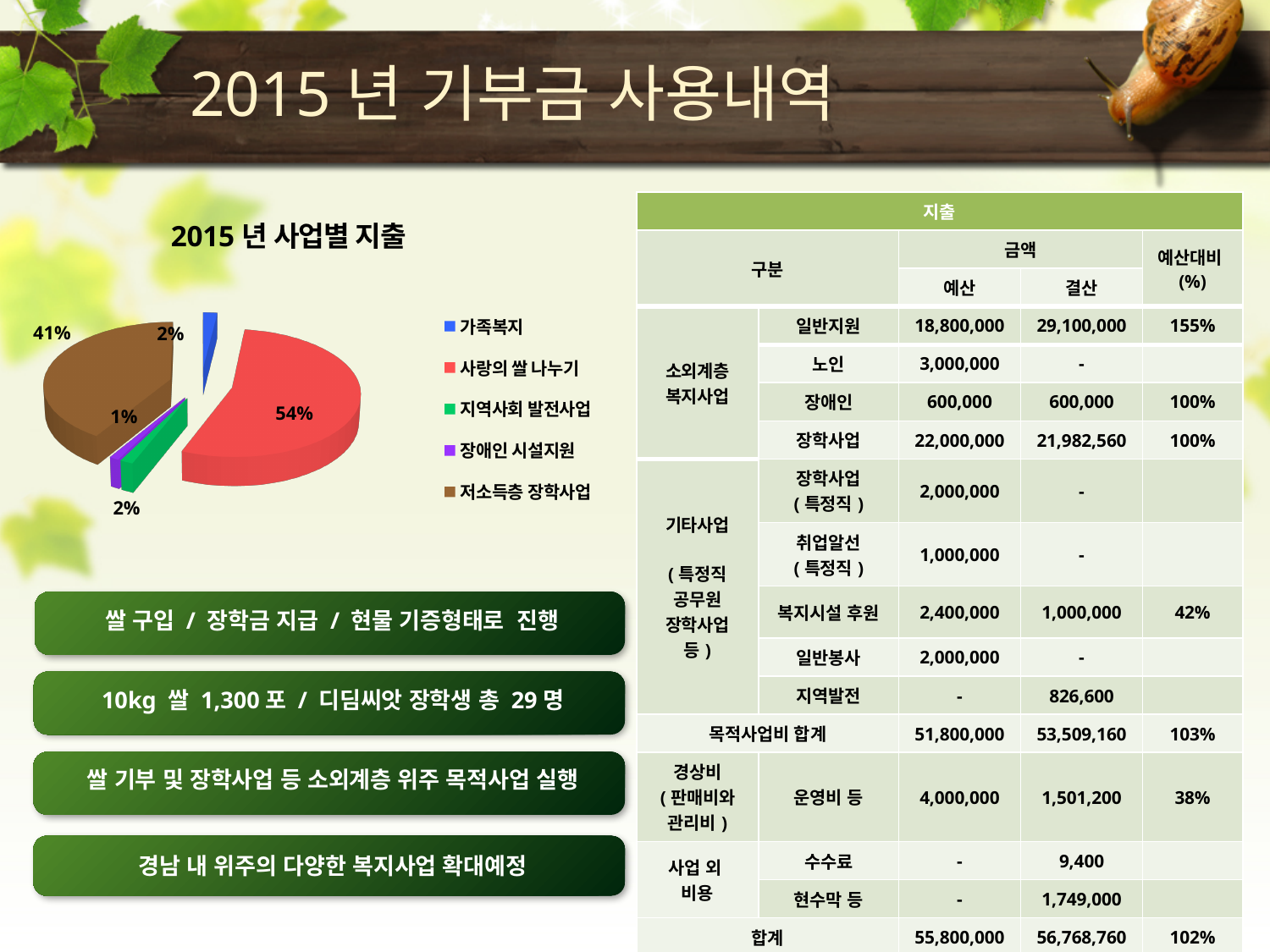
What share of the pie does 가족복지 have? 2% Which category has the smallest share of the pie? 장애인 시설지원 Which colour represents 저소득층 장학사업 in the pie chart? brown What is the difference in percentage points between 사랑의 쌀 나누기 and 저소득층 장학사업? 13% What is the title of the chart on the slide? 2015 년 사업별 지출 What share of the pie does 장애인 시설지원 have? 1% How many entries does the legend of the pie chart list? 5 Which category has the largest share of the pie? 사랑의 쌀 나누기 What share of the pie does 사랑의 쌀 나누기 have? 54% What kind of chart is shown on the slide? pie chart How many slices does the pie chart have? 5